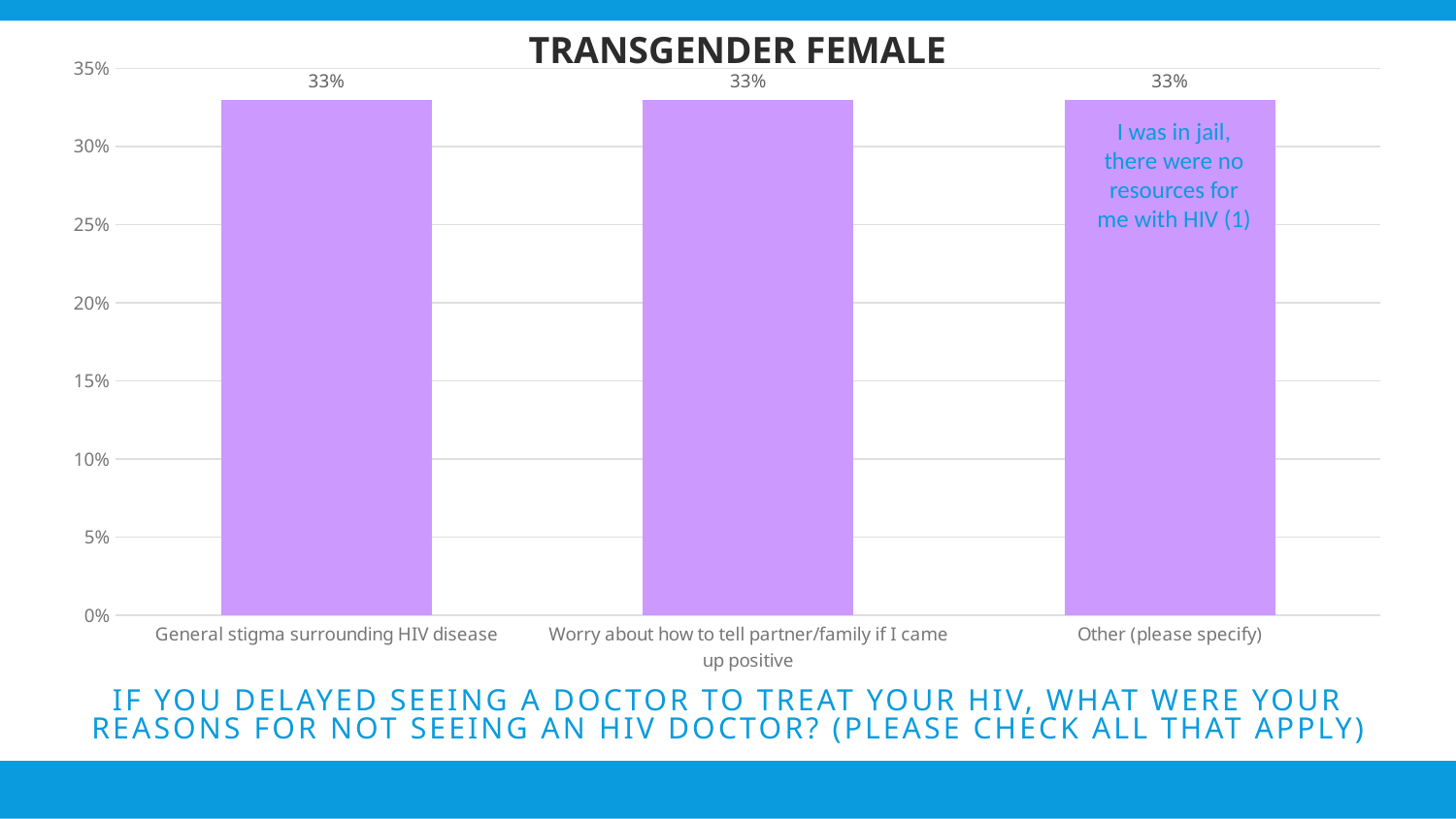
What text is written inside the 'Other (please specify)' bar? I was in jail, there were no resources for me with HIV (1) What is the difference between the values for 'General stigma surrounding HIV disease' and 'Other (please specify)'? 0% What is the value for 'General stigma surrounding HIV disease'? 33% What kind of chart is shown on the slide? bar chart What is the value for 'Worry about how to tell partner/family if I came up positive'? 33% What is the highest value shown on the y axis? 35% Is the value for 'Other (please specify)' greater or less than 30%? greater What is the title of the chart? TRANSGENDER FEMALE What is the value for 'Other (please specify)'? 33% Is the value for 'General stigma surrounding HIV disease' greater or less than 35%? less Do the values rise, fall, or stay the same across the categories from left to right? stay the same How many categories are shown on the x axis? 3